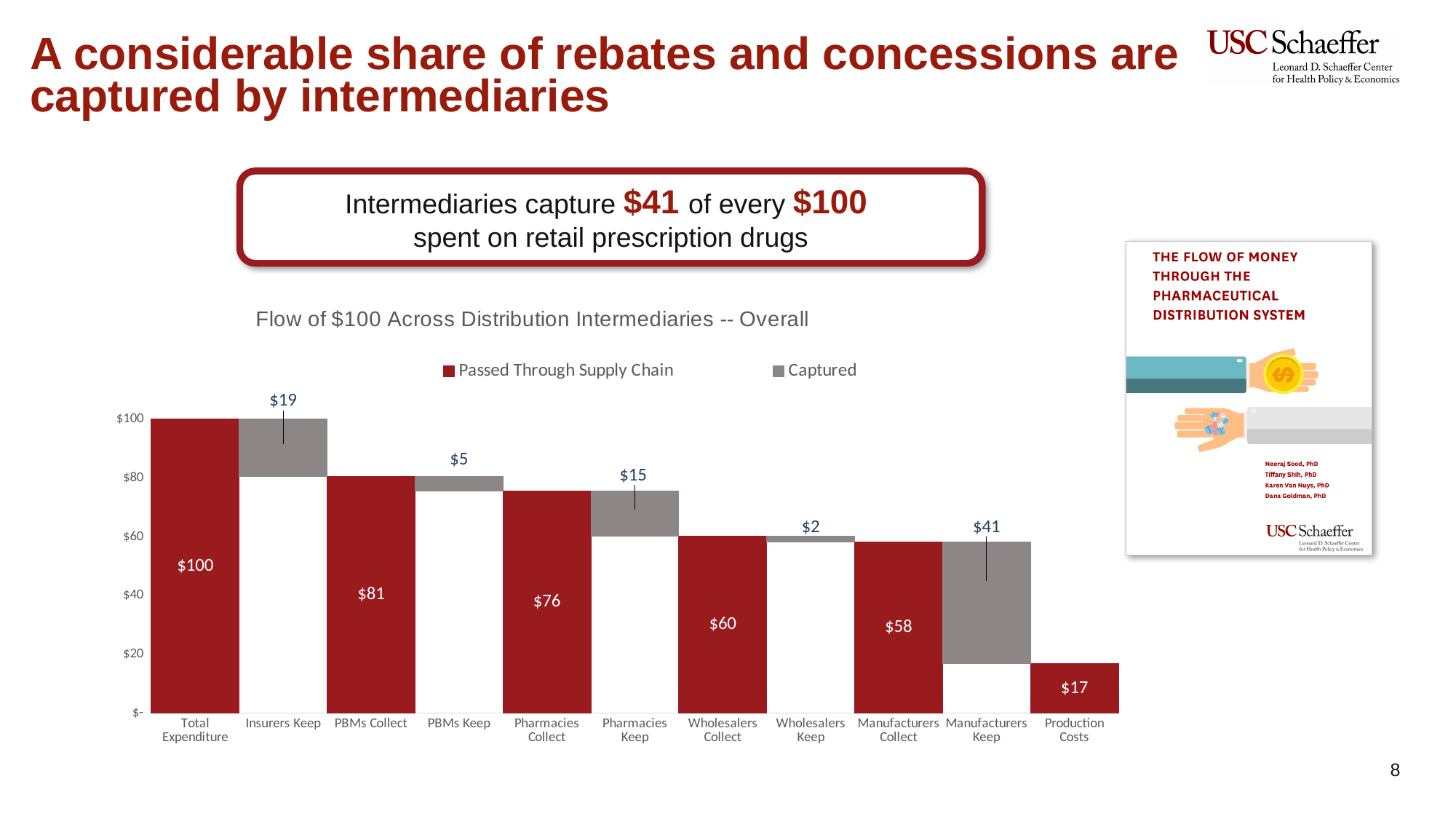
How much do Manufacturers Keep according to the chart? $41 What is the value for Total Expenditure? $100 Which category has the lowest value in the chart? Wholesalers Keep What is the value for Wholesalers Keep? $2 How many categories are shown on the x axis? 11 Which is larger, Insurers Keep or Pharmacies Keep? Insurers Keep Which category has the highest value in the chart? Total Expenditure What is the difference between PBMs Collect and Pharmacies Collect? $5 How many series does the legend list? 2 What kind of chart is shown on the slide? Bar chart What is the title of the chart? Flow of $100 Across Distribution Intermediaries -- Overall What is the value for Production Costs? $17